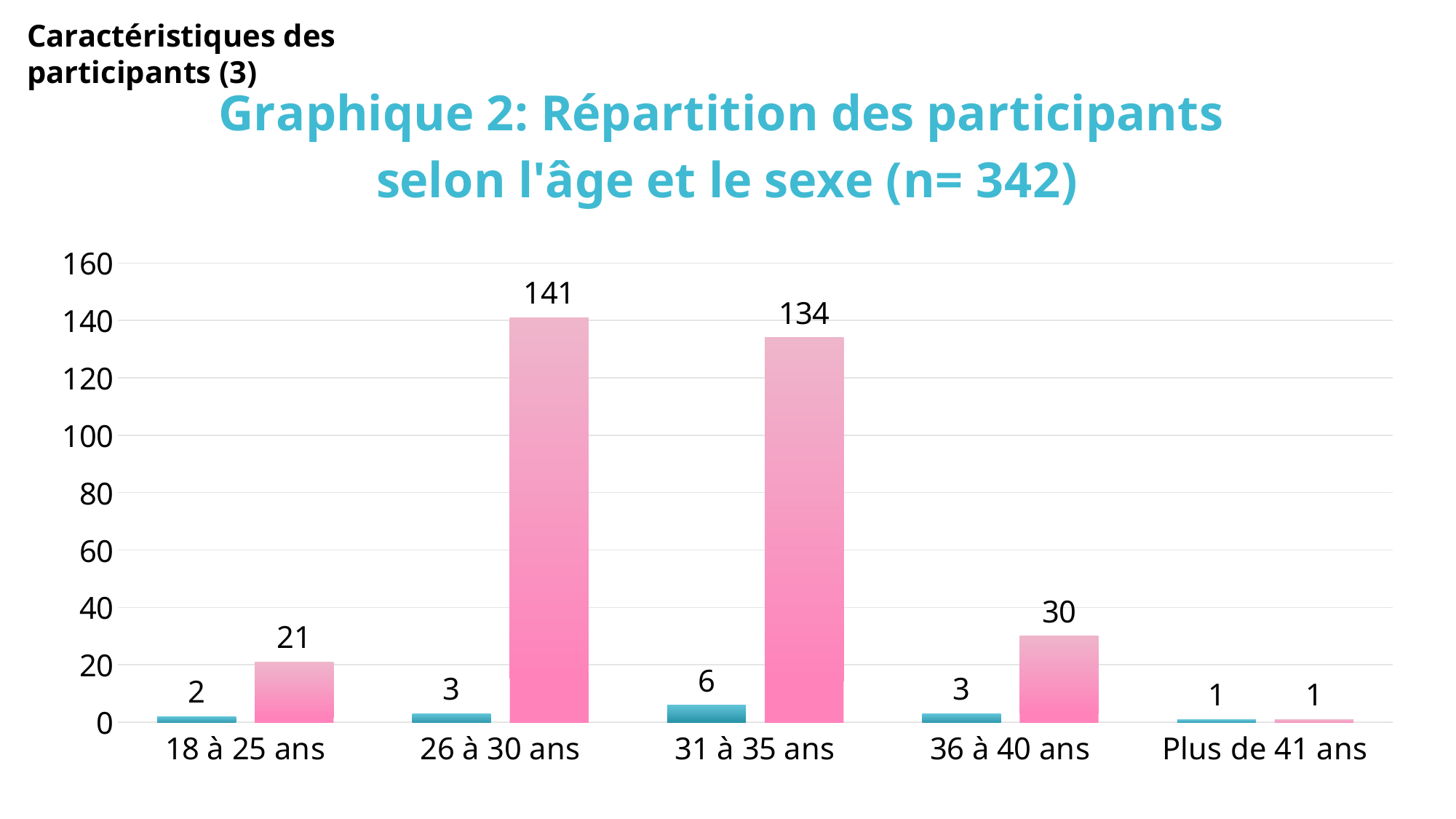
What is the value of the blue bar for the 31 à 35 ans category? 6 Which age category has the lowest pink bar? Plus de 41 ans What is the total of the blue and pink bars for the 18 à 25 ans category? 23 Which is larger: the pink bar for 18 à 25 ans or the pink bar for 36 à 40 ans? 36 à 40 ans What is the difference between the pink bar values for 26 à 30 ans and 31 à 35 ans? 7 What is the value of the pink bar for the 36 à 40 ans category? 30 What type of chart is shown on the slide? bar chart How many age categories are shown on the x axis? 5 What is the value of the blue bar for the 18 à 25 ans category? 2 What is the title of the chart? Graphique 2: Répartition des participants selon l'âge et le sexe (n= 342) What is the value of the pink bar for the 26 à 30 ans category? 141 Which age category has the highest pink bar? 26 à 30 ans